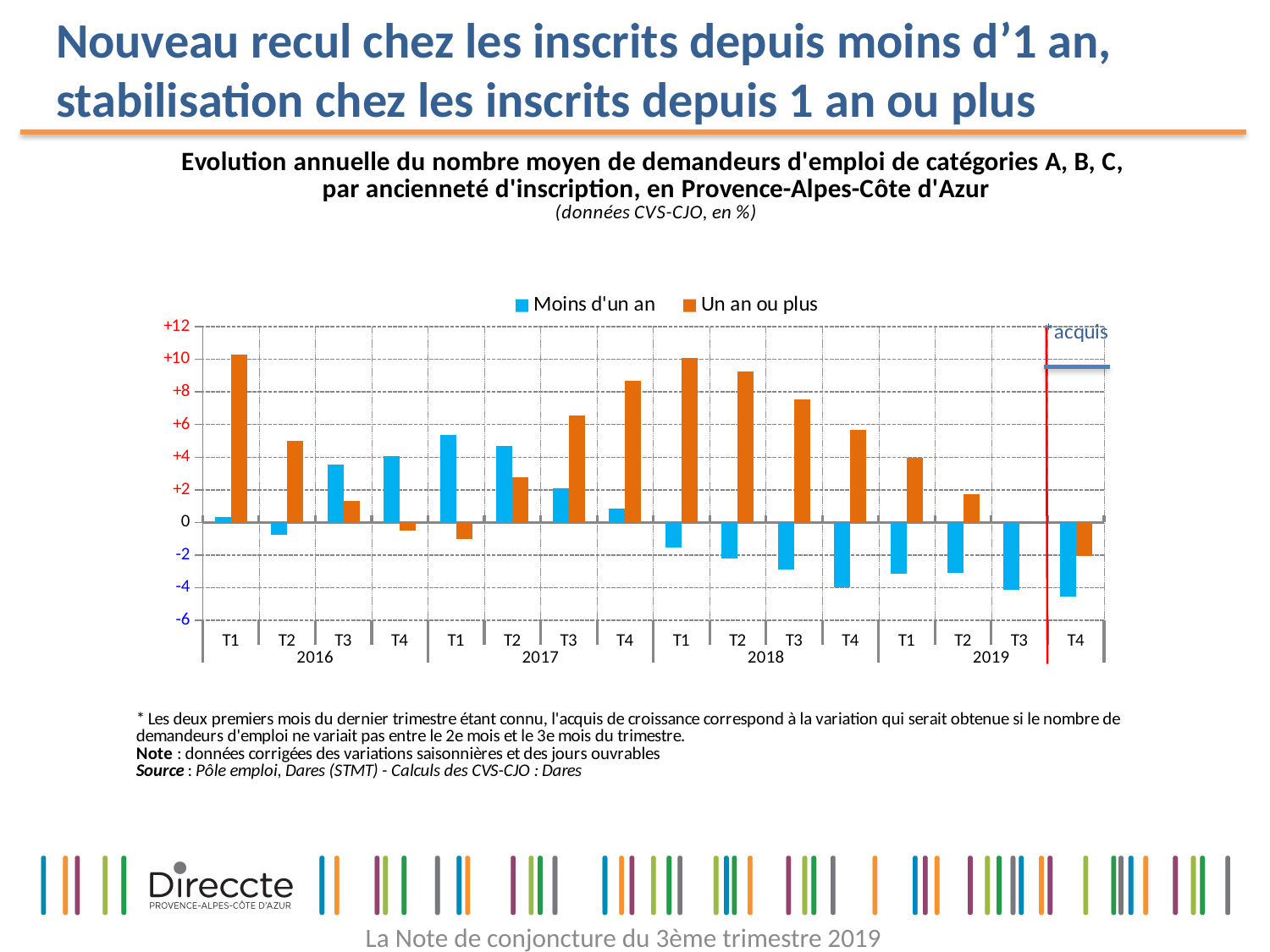
Do the values for 'Un an ou plus' rise or fall from T1 2018 to T4 2019? fall Is the value for 'Un an ou plus' in T1 2016 greater or less than +8? greater How many quarters (T1–T4 categories) are plotted along the x axis? 16 Which colour represents the 'Moins d'un an' series? blue Is the value for 'Moins d'un an' in T1 2017 greater or less than +4? greater What kind of chart is shown on the slide? bar chart In T1 2017, which series has the larger value, 'Moins d'un an' or 'Un an ou plus'? Moins d'un an In T1 2016, which series has the larger value, 'Moins d'un an' or 'Un an ou plus'? Un an ou plus What are the two series named in the legend? Moins d'un an; Un an ou plus How many series does the legend list? 2 Is the value for 'Moins d'un an' in T4 2018 greater or less than -2? less